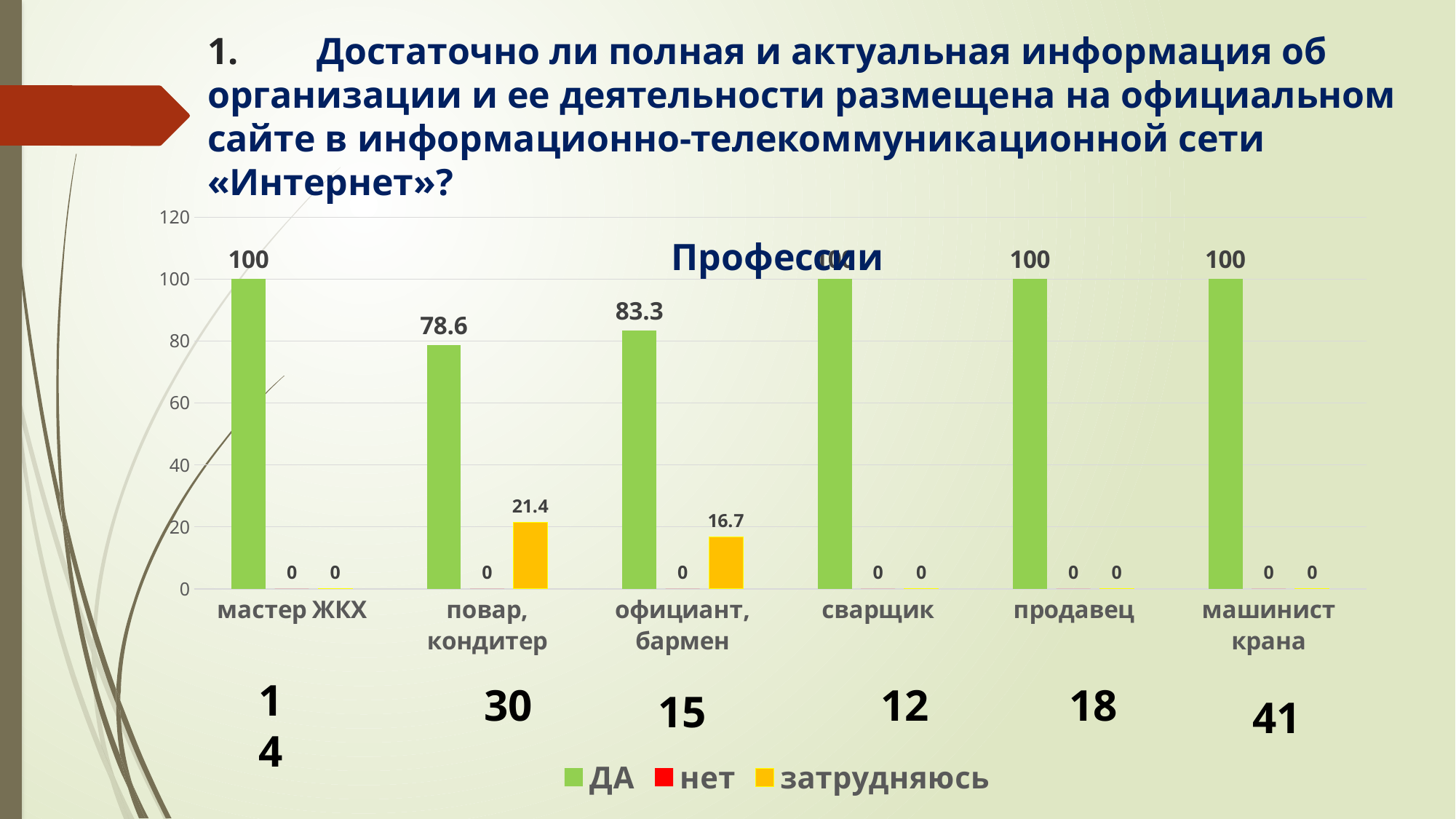
What is the value of the затрудняюсь series for официант, бармен? 16.7 Which category has the lowest value in the ДА series? повар, кондитер Which category has the highest value in the затрудняюсь series? повар, кондитер How many series does the legend list? 3 How many categories are shown on the x axis? 6 What is the value of the ДА series for официант, бармен? 83.3 What is the difference between the ДА values for официант, бармен and повар, кондитер? 4.7 What is the value of the ДА series for повар, кондитер? 78.6 Which is larger: the затрудняюсь value for повар, кондитер or for официант, бармен? повар, кондитер What is the value of the нет series for сварщик? 0 What is the value of the затрудняюсь series for повар, кондитер? 21.4 What type of chart is shown on the slide? bar chart